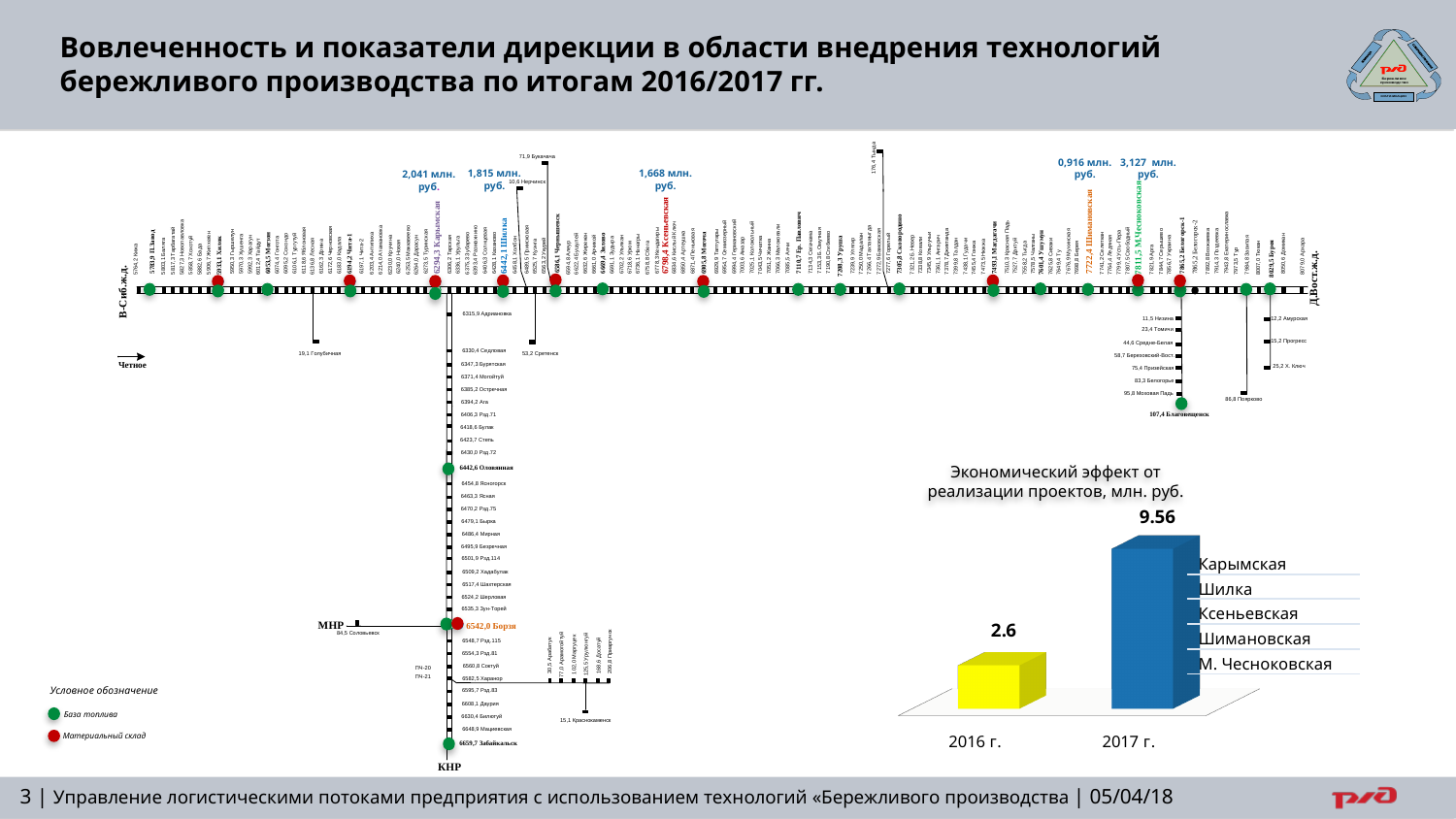
In the bar chart on the lower right, do the values rise or fall from 2016 г. to 2017 г.? rise In the chart 'Экономический эффект от реализации проектов', what is the difference between the 2017 г. and 2016 г. values? 6.96 In the bar chart on the lower right, which year has the lowest value? 2016 г. In the bar chart on the lower right, which year has the highest value? 2017 г. What is the title of the bar chart on the lower right of the slide? Экономический эффект от реализации проектов, млн. руб. In the bar chart on the lower right, which is larger: the value for 2016 г. or for 2017 г.? 2017 г. In what units are the values of the bar chart on the lower right expressed, according to its title? млн. руб. What kind of chart is 'Экономический эффект от реализации проектов, млн. руб.'? bar chart In the chart 'Экономический эффект от реализации проектов, млн. руб.', what is the value for 2016 г.? 2.6 How many categories are shown on the x axis of the bar chart on the lower right? 2 In the chart 'Экономический эффект от реализации проектов, млн. руб.', what is the value for 2017 г.? 9.56